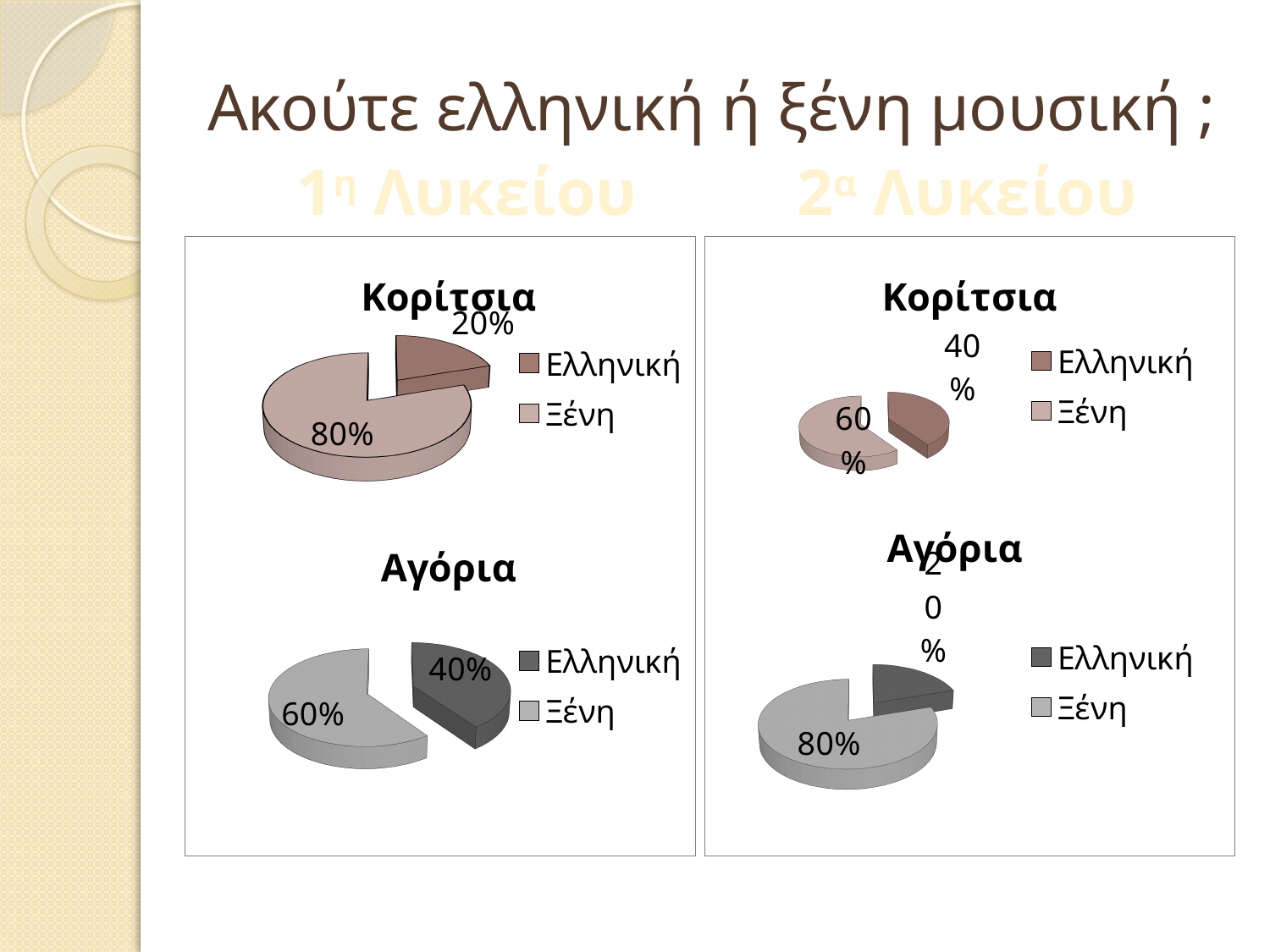
What type of chart is used on this slide? Pie chart In the bottom-right pie chart (Αγόρια, 2α Λυκείου), what share is labelled for Ξένη? 80% In the top-left pie chart (Κορίτσια, 1η Λυκείου), which slice is the largest? Ξένη In the bottom-left pie chart (Αγόρια, 1η Λυκείου), what is the difference between the Ξένη and Ελληνική shares? 20% In the bottom-left pie chart (Αγόρια, 1η Λυκείου), what share is labelled for Ξένη? 60% In the bottom-right pie chart (Αγόρια, 2α Λυκείου), which slice is the smallest? Ελληνική In the top-right pie chart (Κορίτσια, 2α Λυκείου), which is larger, Ελληνική or Ξένη? Ξένη In the bottom-left pie chart (Αγόρια, 1η Λυκείου), what share is labelled for Ελληνική? 40% In the top-left pie chart (Κορίτσια, 1η Λυκείου), what share is labelled for Ελληνική? 20% In the top-left pie chart (Κορίτσια, 1η Λυκείου), what share is labelled for Ξένη? 80% How many entries does the legend of the top-left pie chart list? 2 In the top-right pie chart (Κορίτσια, 2α Λυκείου), what share is labelled for Ελληνική? 40%